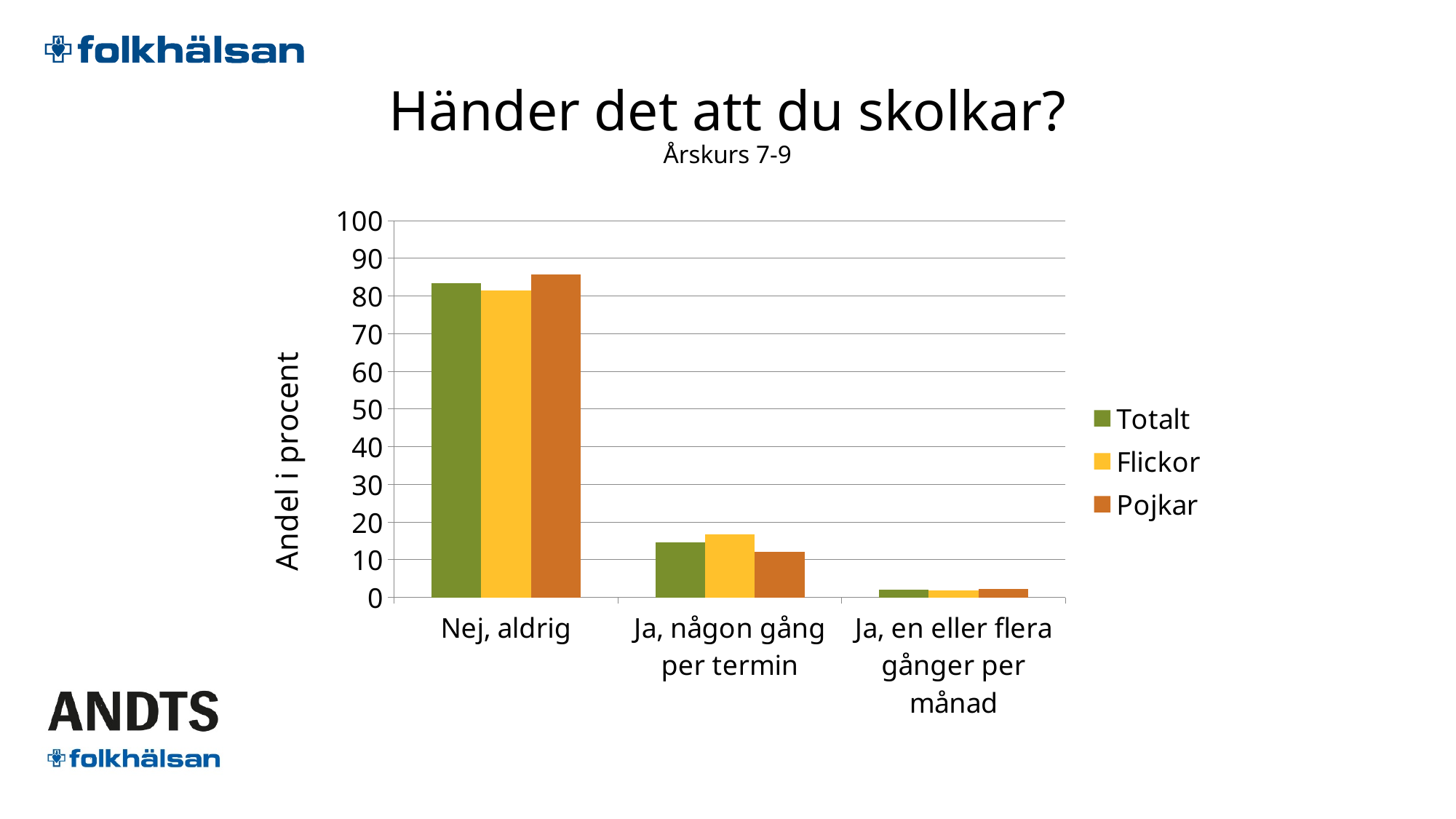
What is the title of the y axis? Andel i procent In the 'Ja, någon gång per termin' category, which is larger: Flickor or Pojkar? Flickor Is the Pojkar value for 'Ja, någon gång per termin' greater or less than 20? less Which colour represents the Flickor series in the legend? Yellow Do the Totalt values rise or fall from left to right along the x axis? fall What kind of chart is shown on the slide? Bar chart In the 'Nej, aldrig' category, which is larger: Flickor or Pojkar? Pojkar How many categories are shown on the x axis? 3 Is the Totalt value for 'Nej, aldrig' greater or less than 70? greater For the Totalt series, which category has the highest value? Nej, aldrig How many series does the legend list? 3 For the Pojkar series, which category has the lowest value? Ja, en eller flera gånger per månad